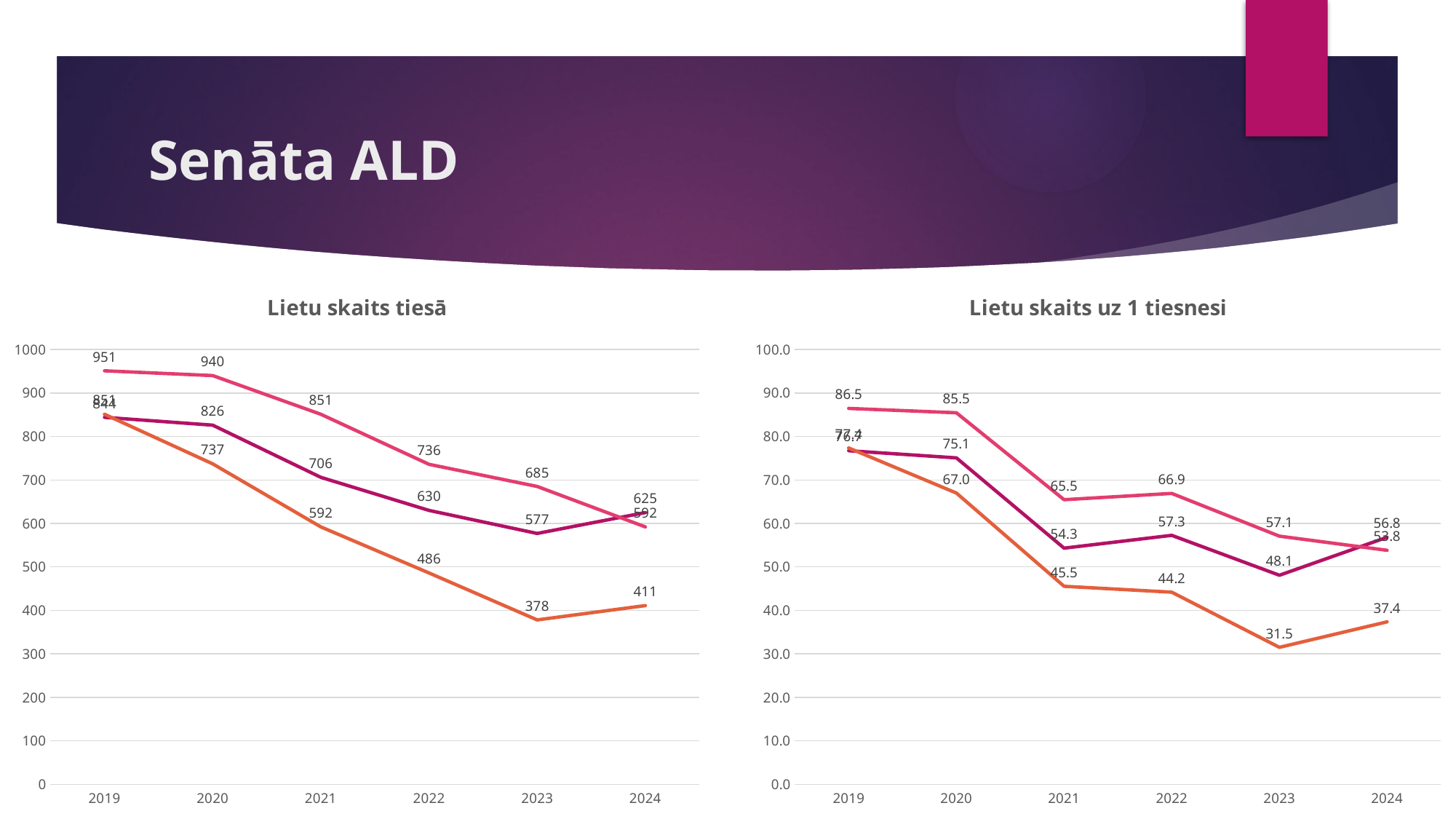
In the chart titled "Lietu skaits tiesā", by how much does the top (pink) line fall from 2020 to 2021? 89 In the chart titled "Lietu skaits uz 1 tiesnesi", what is the value of the top (pink) line in 2020? 85.5 In the chart titled "Lietu skaits tiesā", what is the value of the top (pink) line in 2019? 951 In the chart titled "Lietu skaits tiesā", what is the value of the middle (magenta) line in 2022? 630 In the chart titled "Lietu skaits tiesā", how many years are shown on the x axis? 6 What is the title of the chart on the right side of the slide? Lietu skaits uz 1 tiesnesi In the chart titled "Lietu skaits uz 1 tiesnesi", what is the value of the orange (bottom) line in 2023? 31.5 In the chart titled "Lietu skaits tiesā", what is the value of the orange (bottom) line in 2023? 378 What kind of chart is the chart titled "Lietu skaits tiesā"? line chart In the chart titled "Lietu skaits uz 1 tiesnesi", does the orange (bottom) line rise or fall from 2019 to 2023? fall In the chart titled "Lietu skaits uz 1 tiesnesi", which line has the higher value in 2024, the pink line or the magenta line? the magenta line In the chart titled "Lietu skaits tiesā", in which year does the orange (bottom) line reach its lowest value? 2023